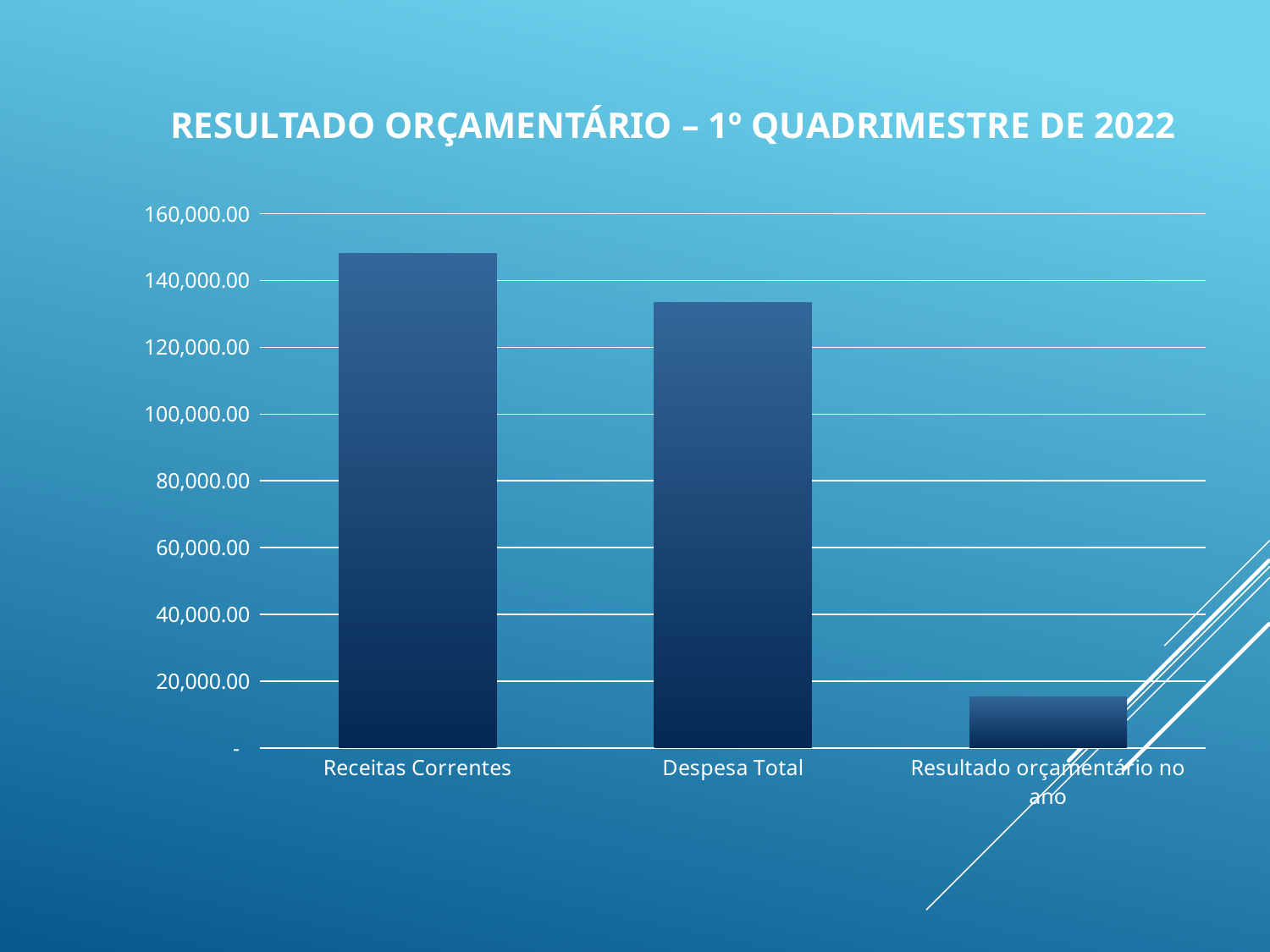
Is the value for Despesa Total greater or less than 120,000.00? greater Do the bar values rise or fall from left to right across the categories? fall What is the highest value shown on the vertical axis? 160,000.00 Which category has the highest value? Receitas Correntes What is the title of the slide? RESULTADO ORÇAMENTÁRIO – 1º QUADRIMESTRE DE 2022 Which is larger, Receitas Correntes or Despesa Total? Receitas Correntes Is the value for Despesa Total greater or less than 140,000.00? less What kind of chart is shown on the slide? bar chart Is the value for Resultado orçamentário no ano greater or less than 20,000.00? less How many categories are plotted on the chart? 3 Which category has the lowest value? Resultado orçamentário no ano